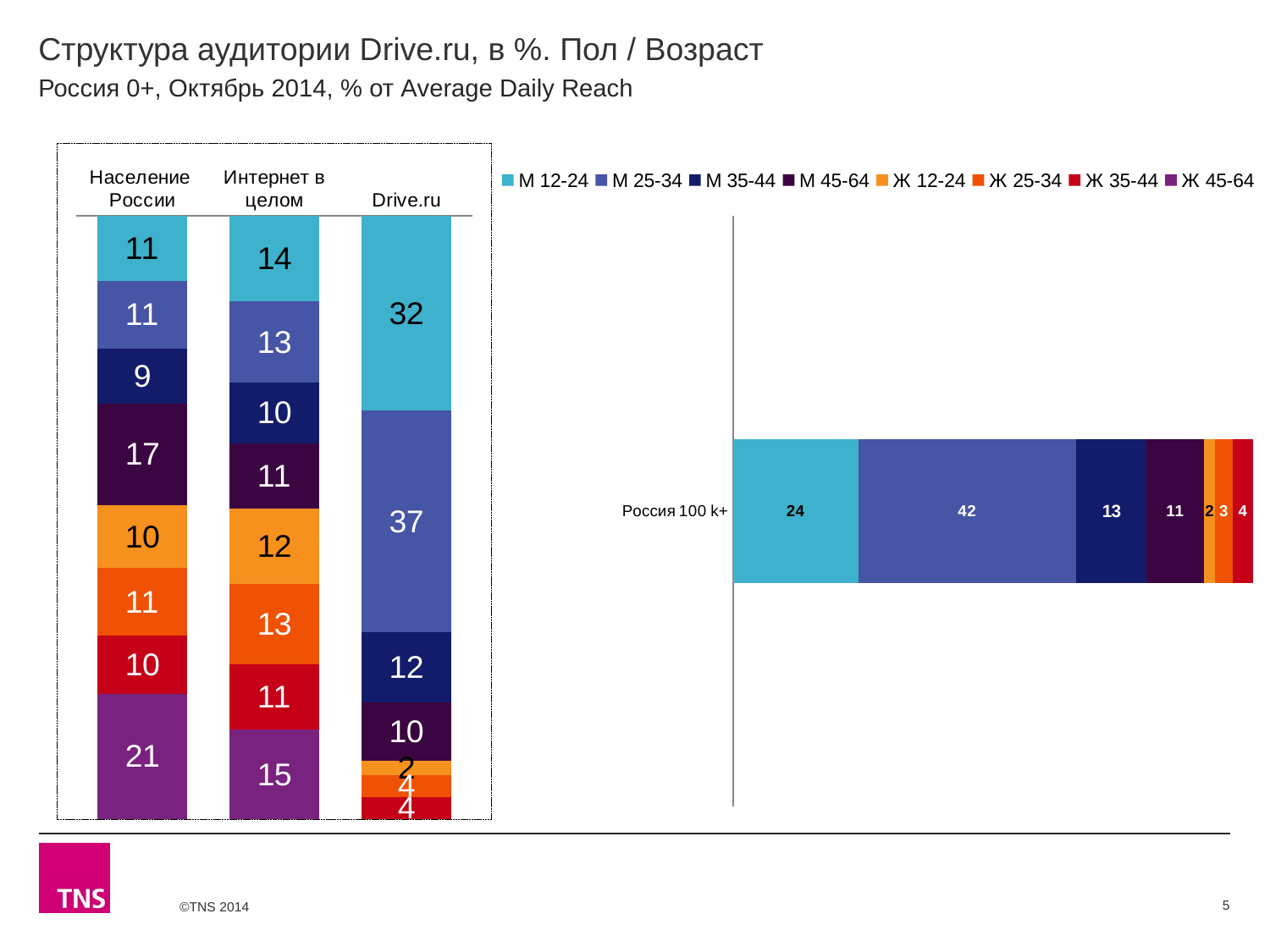
How many columns (categories) are shown in the left chart? 3 In the left chart, what is the value for М 12-24 in the Drive.ru column? 32 What kind of chart is the right chart (Россия 100 k+)? Stacked bar chart In the right chart (Россия 100 k+), what is the value for М 12-24? 24 In the left chart, which segment is the largest in the Drive.ru column? М 25-34 In the right chart (Россия 100 k+), what is the value for М 25-34? 42 In the left chart, which segment is the smallest in the Население России column? М 35-44 In the left chart, what is the difference between the М 25-34 value for Drive.ru and the М 25-34 value for Население России? 26 In the left chart, what is the value for Ж 45-64 in the Население России column? 21 In the left chart, what is the value for М 35-44 in the Интернет в целом column? 10 In the right chart (Россия 100 k+), which is larger: М 35-44 or М 45-64? М 35-44 How many series does the legend list? 8